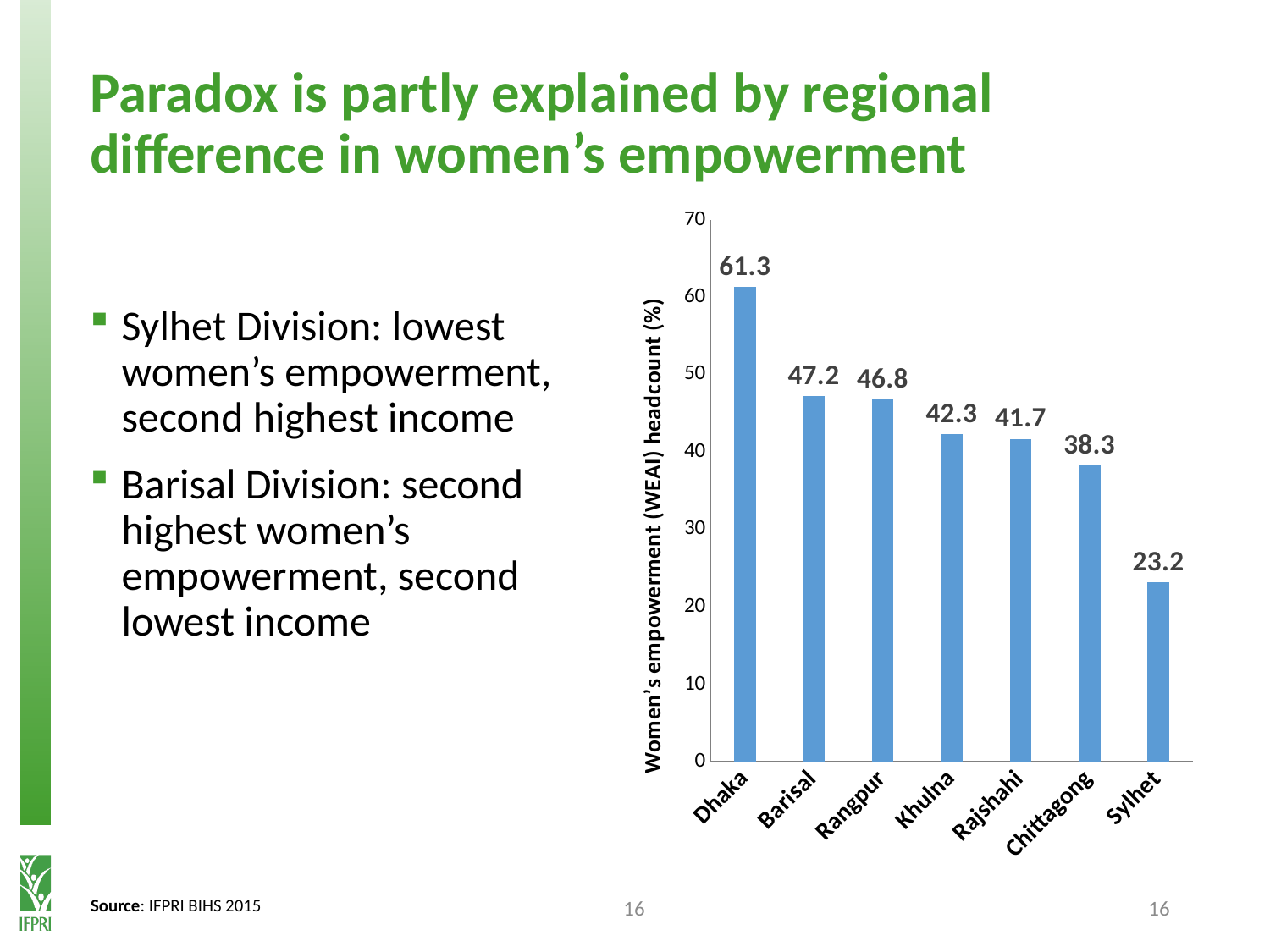
Is the value for Chittagong greater or less than 40? less What is the value shown for Sylhet? 23.2 What is the value shown for Khulna? 42.3 Which has a larger value, Chittagong or Rajshahi? Rajshahi What kind of chart is shown on the slide? bar chart What is the difference between the values for Barisal and Rangpur? 0.4 Which division has the lowest women's empowerment headcount? Sylhet How many divisions are shown in the chart? 7 What is the difference between the values for Dhaka and Sylhet? 38.1 Which division has the highest women's empowerment headcount? Dhaka Do the values rise or fall from left to right along the x axis? fall What is the women's empowerment (WEAI) headcount value for Dhaka? 61.3